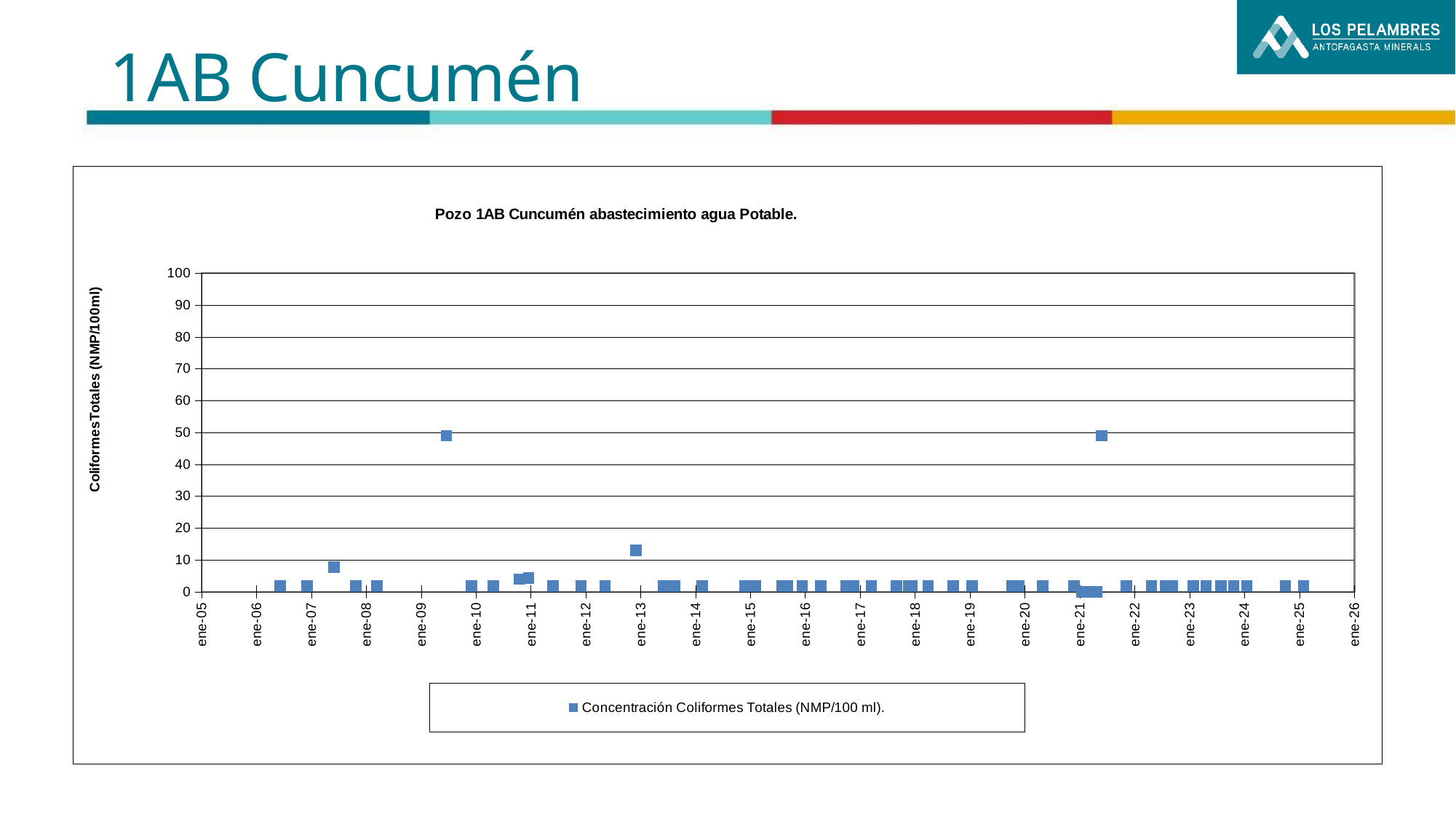
Are the values plotted between ene-14 and ene-20 greater or less than 10? less What is the maximum value shown on the vertical axis? 100 What is the title of the chart? Pozo 1AB Cuncumén abastecimiento agua Potable. How many series does the legend list? 1 What is the label of the vertical axis? Coliformes Totales (NMP/100ml) Is the highest value plotted between ene-21 and ene-22 greater or less than 40? greater Is the value plotted between ene-07 and ene-08 greater or less than 10? less What kind of chart is shown on the slide? scatter chart